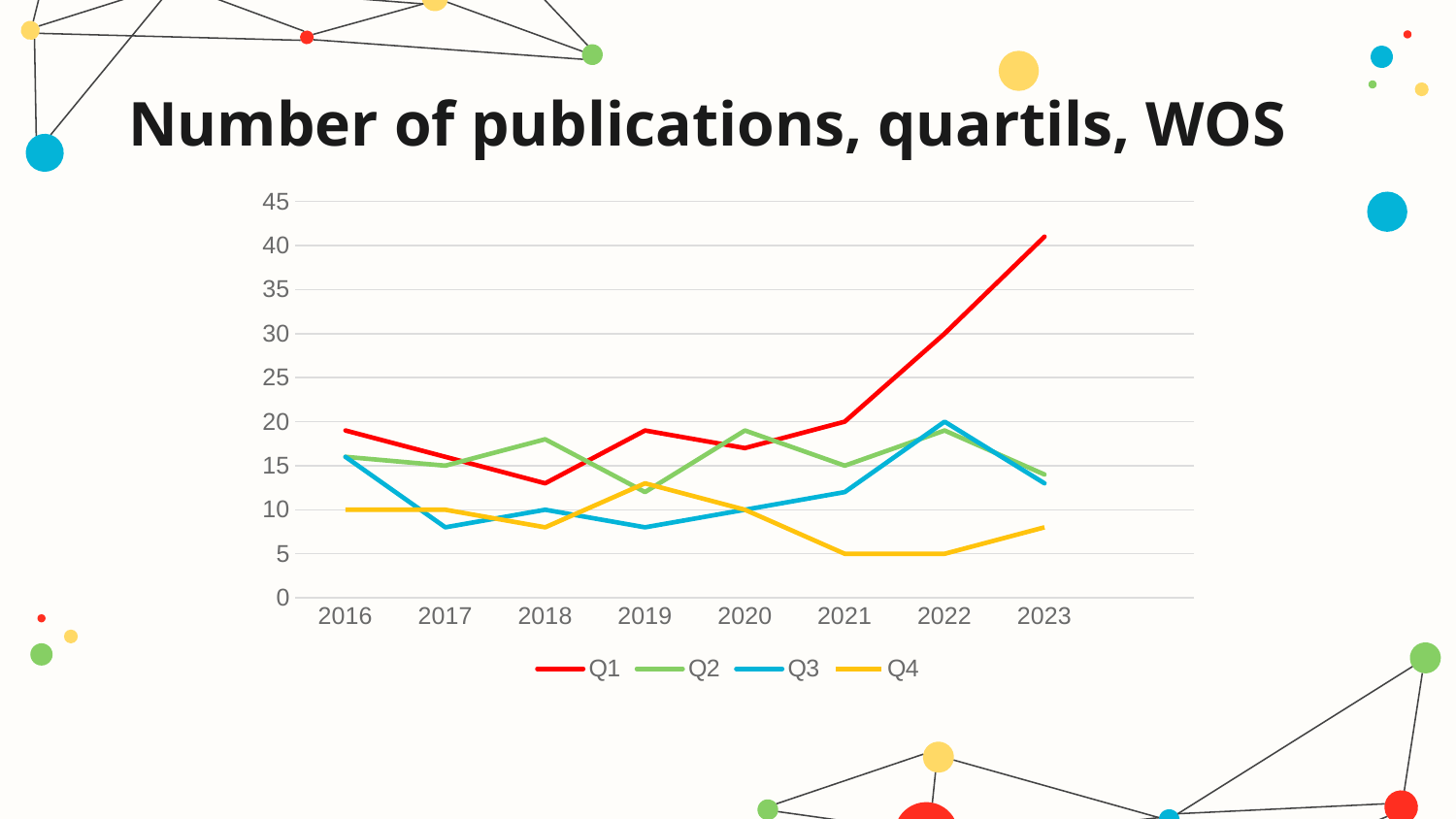
Which series has the lowest value in 2023? Q4 How many series does the legend list? 4 What is the value for Q3 in 2022? 20 How many years are shown on the x axis? 8 What type of chart is shown on the slide? line chart What is the value for Q4 in 2021? 5 Is the value for Q1 in 2023 greater or less than 35? greater What is the title of the chart? Number of publications, quartils, WOS Which is larger in 2019, the value for Q2 or the value for Q3? Q2 Does the Q1 line rise or fall from 2021 to 2023? rise What is the value for Q1 in 2021? 20 Which series has the highest value in 2023? Q1